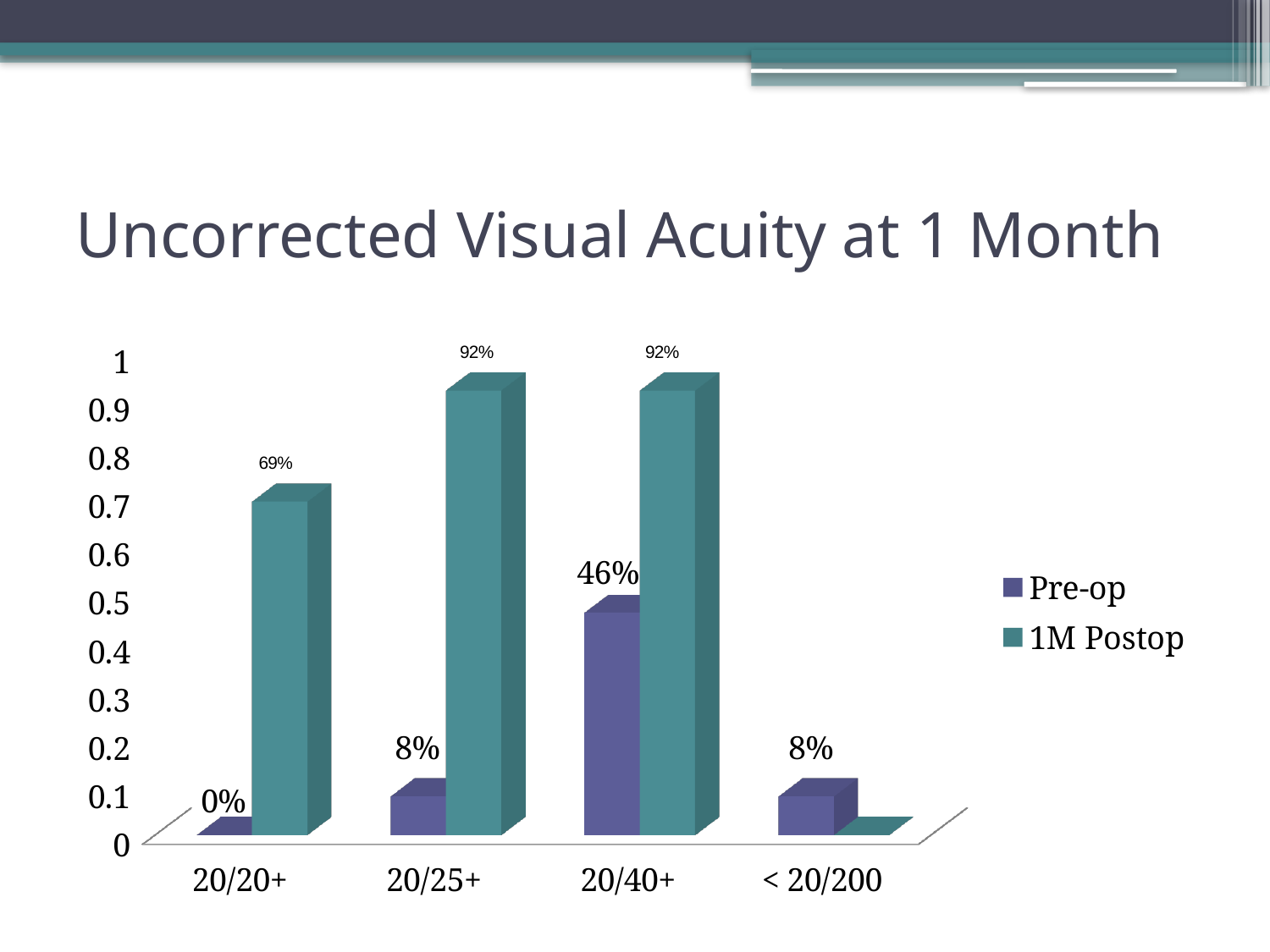
How many categories are shown on the x axis? 4 What is the 1M Postop value for 20/20+? 69% Which category has the highest Pre-op value? 20/40+ For 20/40+, which is larger: the Pre-op value or the 1M Postop value? 1M Postop How many series does the legend list? 2 What kind of chart is shown on the slide? Bar chart What is the difference between the 1M Postop values for 20/25+ and 20/20+? 23 percentage points What is the Pre-op value for 20/40+? 46% What is the 1M Postop value for 20/25+? 92% What is the Pre-op value for 20/20+? 0% What is the Pre-op value for < 20/200? 8% Which category has the lowest Pre-op value? 20/20+